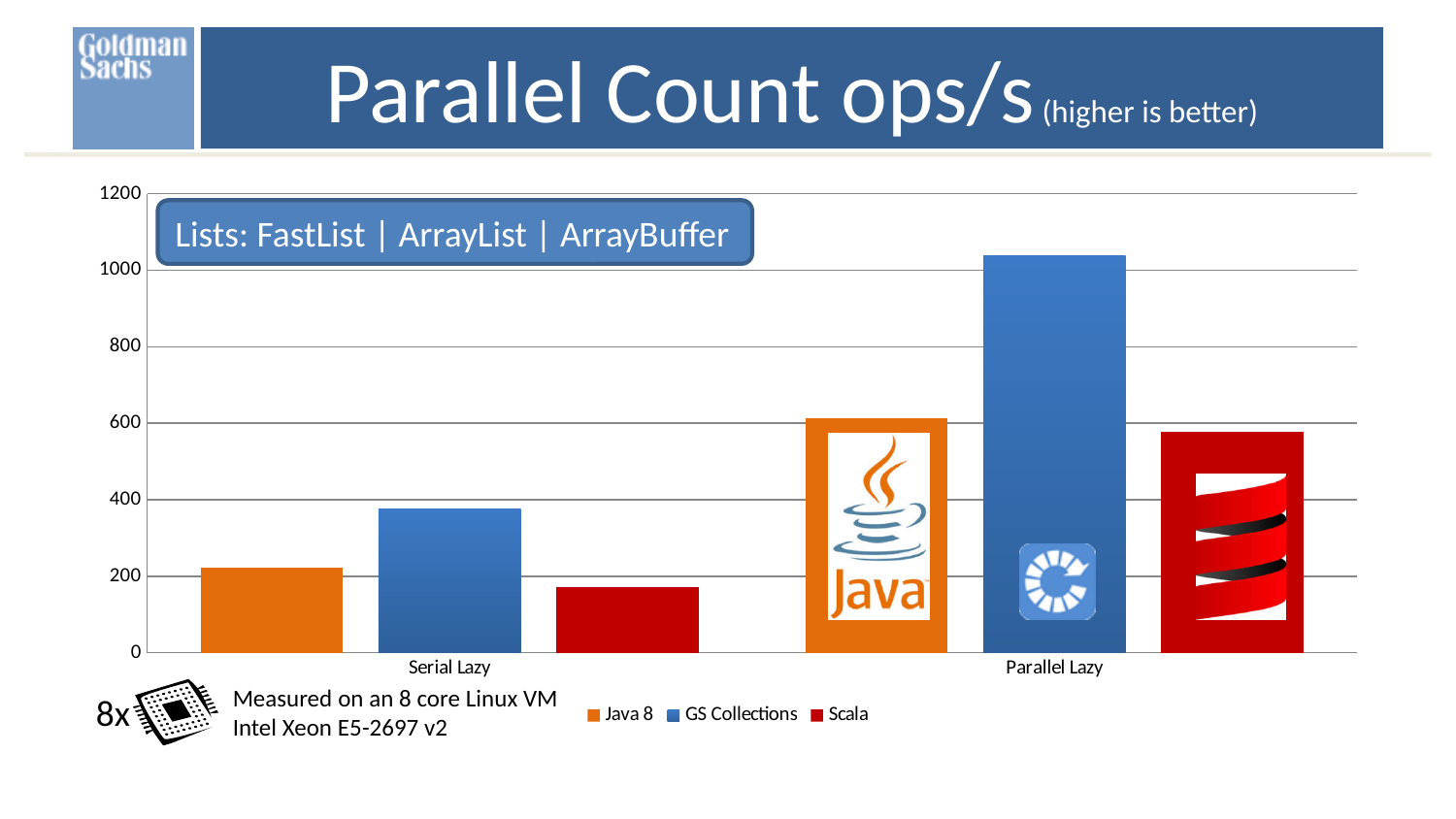
Is the value for Scala in the Serial Lazy category greater or less than 200? less Which series has the lowest bar in the Serial Lazy category? Scala What is the title of the chart on the slide? Parallel Count ops/s (higher is better) Do the values for GS Collections rise or fall from Serial Lazy to Parallel Lazy? rise What kind of chart is shown on the slide? bar chart Is the value for Java 8 in the Parallel Lazy category greater or less than 400? greater Is the value for GS Collections in the Serial Lazy category greater or less than 200? greater How many series does the chart legend list? 3 How many categories are shown on the x axis of the chart? 2 Which is larger in the Serial Lazy category, Java 8 or Scala? Java 8 Which series has the highest bar in the Parallel Lazy category? GS Collections